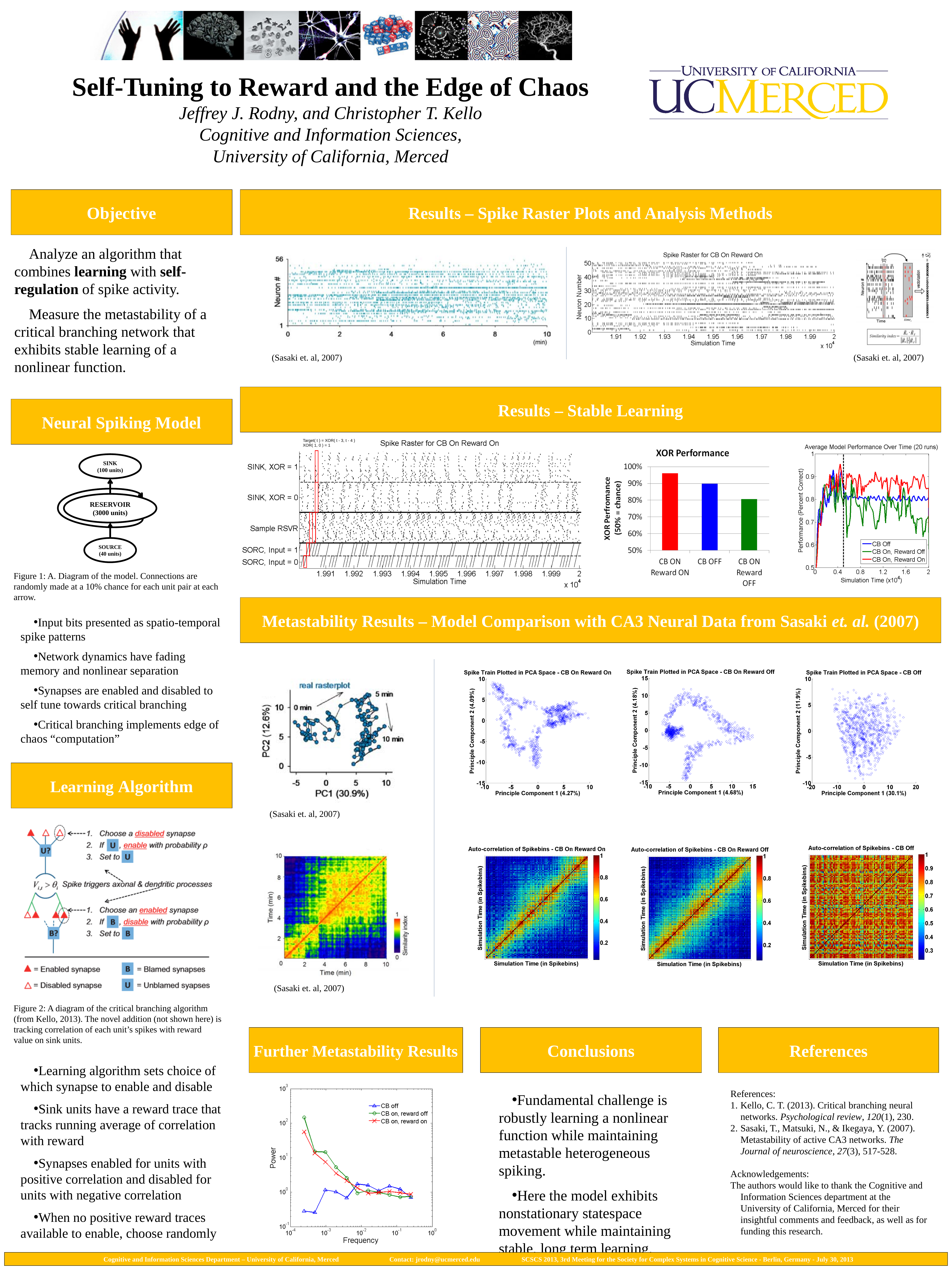
In the XOR Performance chart, is the value for CB ON Reward ON greater or less than 100%? less In the XOR Performance chart, is the value for CB ON Reward OFF greater or less than 90%? less What is the x-axis label of the chart under 'Further Metastability Results'? Frequency In the 'Average Model Performance Over Time (20 runs)' chart, which series has the highest performance at the end of the simulation time? CB On, Reward On In the XOR Performance chart, is the value for CB ON Reward ON greater or less than 90%? greater What kind of chart is the XOR Performance chart? bar chart In the XOR Performance chart, which condition has the highest performance? CB ON Reward ON What are the legend entries of the chart under 'Further Metastability Results'? CB off, CB on reward off, CB on reward on In the XOR Performance chart, which is larger: CB OFF or CB ON Reward OFF? CB OFF How many series does the legend of the 'Average Model Performance Over Time (20 runs)' chart list? 3 How many bars are shown in the XOR Performance chart? 3 In the XOR Performance chart, which condition has the lowest performance? CB ON Reward OFF